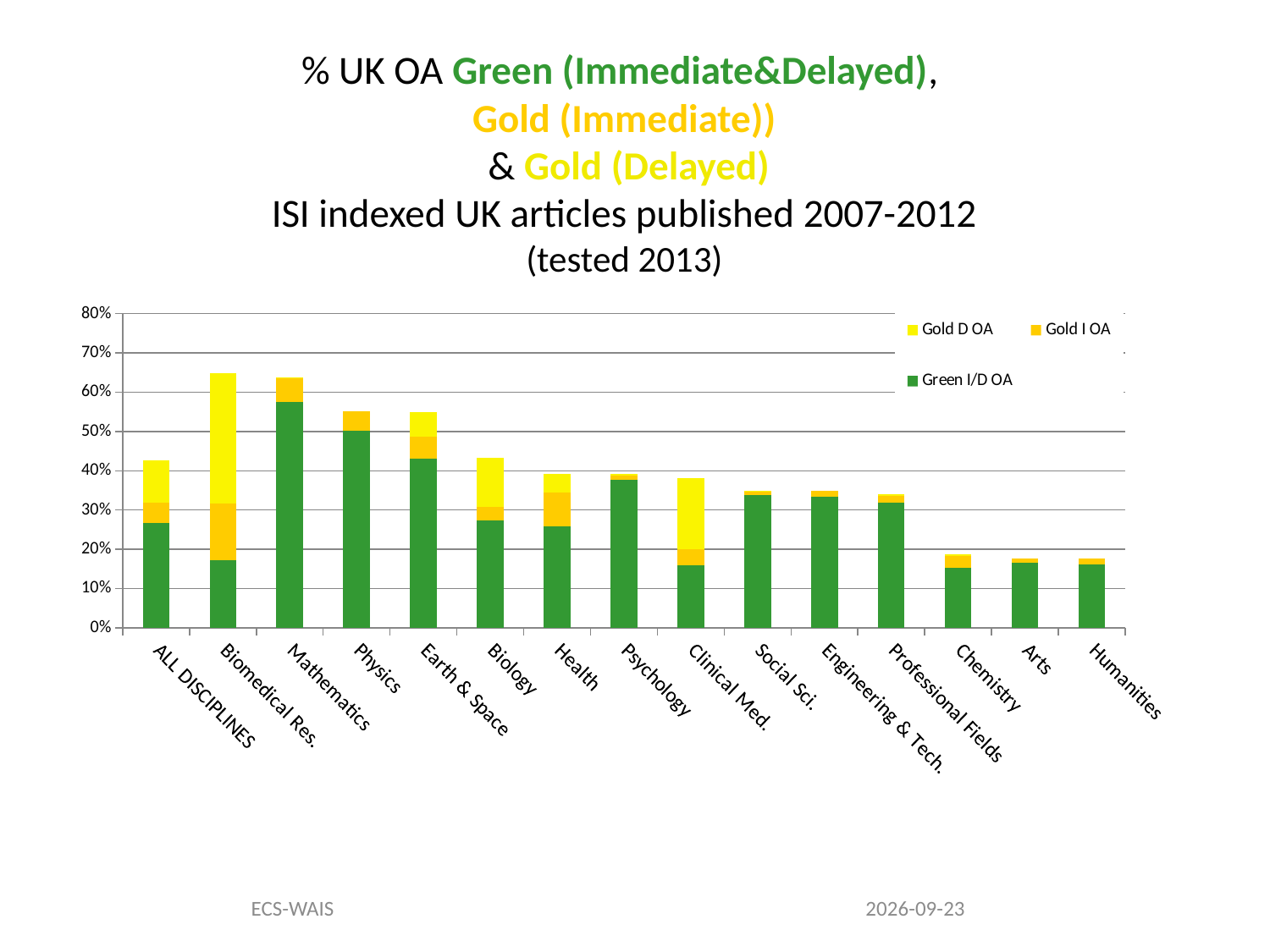
Is the Green I/D OA value for Mathematics greater or less than 50%? greater Is the Green I/D OA value for Biomedical Res. greater or less than 20%? less Which discipline has the largest Gold D OA segment? Biomedical Res. Which series in the legend is shown in green? Green I/D OA Which has the taller total stacked bar, Biomedical Res. or Physics? Biomedical Res. Which has the larger Green I/D OA segment, Earth & Space or Biology? Earth & Space Which discipline has the tallest Green I/D OA segment? Mathematics How many discipline categories are shown on the x axis of the chart? 15 What kind of chart is shown on the slide? stacked bar chart Is the total stacked bar for Chemistry greater or less than 20%? less How many series does the chart's legend list? 3